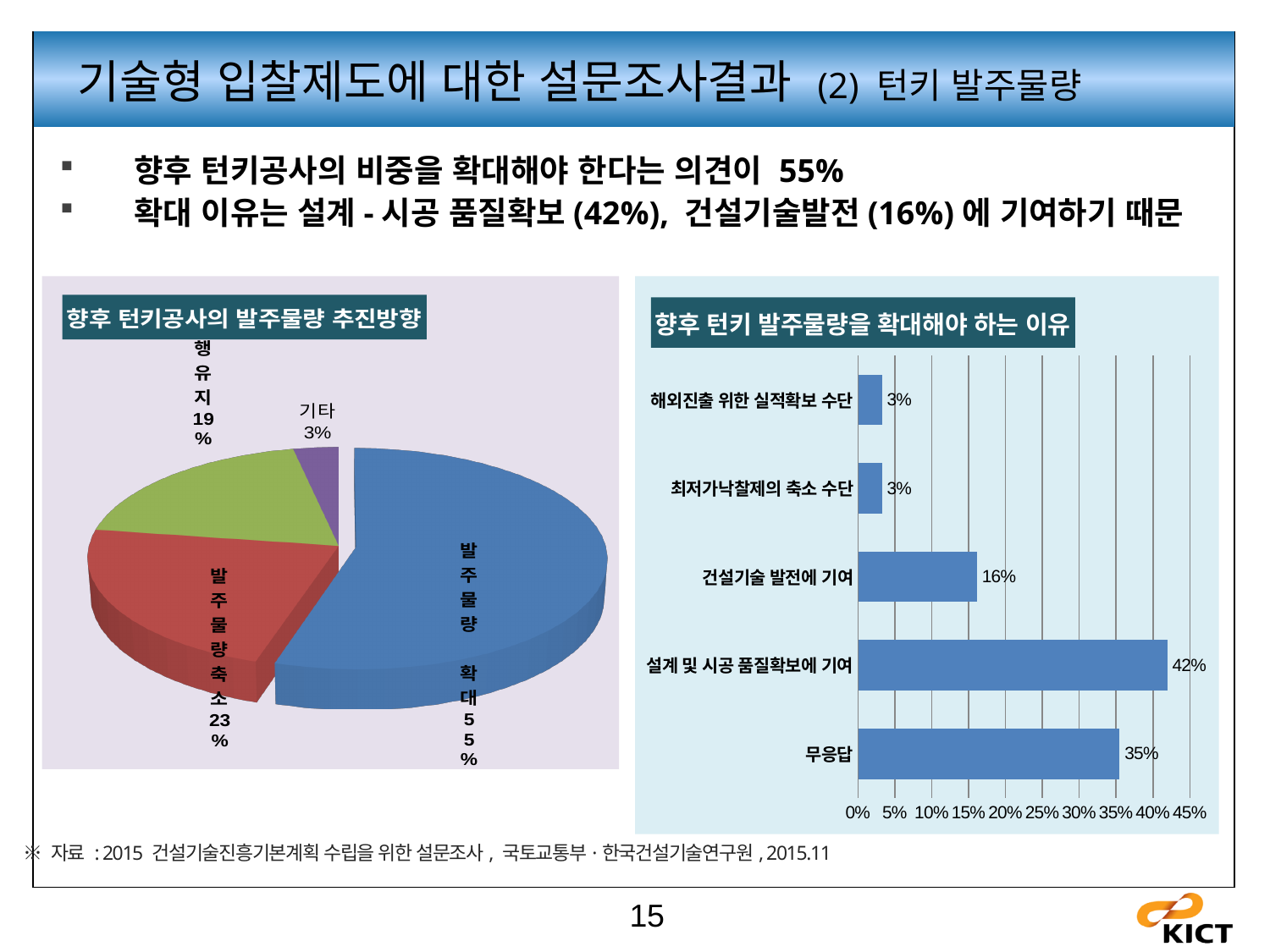
In the pie chart titled 향후 턴키공사의 발주물량 추진방향, which slice is the largest? 발주물량 확대 In the pie chart titled 향후 턴키공사의 발주물량 추진방향, what is the difference between the 발주물량 확대 and 발주물량 축소 shares? 32% What type of chart is the one titled 향후 턴키 발주물량을 확대해야 하는 이유? Bar chart In the bar chart titled 향후 턴키 발주물량을 확대해야 하는 이유, how many categories are shown? 5 In the pie chart titled 향후 턴키공사의 발주물량 추진방향, what share is labelled for 발주물량 확대? 55% In the pie chart titled 향후 턴키공사의 발주물량 추진방향, how many slices are there? 4 In the pie chart titled 향후 턴키공사의 발주물량 추진방향, what share is labelled for 기타? 3% In the bar chart titled 향후 턴키 발주물량을 확대해야 하는 이유, what is the value for 설계 및 시공 품질확보에 기여? 42% In the bar chart titled 향후 턴키 발주물량을 확대해야 하는 이유, what is the value for 무응답? 35% In the bar chart titled 향후 턴키 발주물량을 확대해야 하는 이유, which category has the highest value? 설계 및 시공 품질확보에 기여 In the pie chart titled 향후 턴키공사의 발주물량 추진방향, what share is labelled for 발주물량 축소? 23% In the bar chart titled 향후 턴키 발주물량을 확대해야 하는 이유, what is the value for 건설기술 발전에 기여? 16%